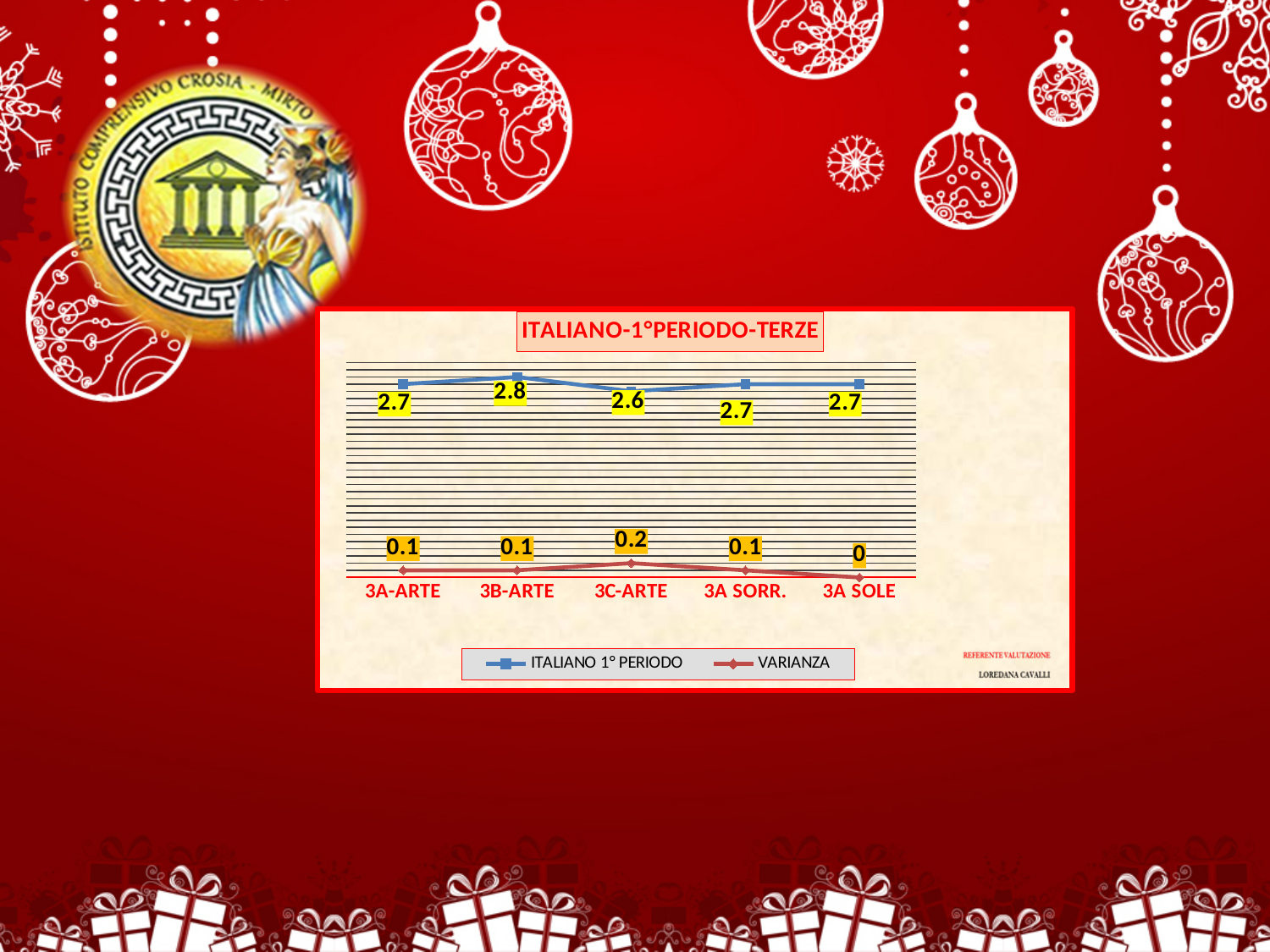
Which category has the highest ITALIANO 1° PERIODO value? 3B-ARTE What is the VARIANZA value for 3A SOLE? 0 Which category has the highest VARIANZA value? 3C-ARTE What is the ITALIANO 1° PERIODO value for 3B-ARTE? 2.8 What is the VARIANZA value for 3C-ARTE? 0.2 Which category has the lowest ITALIANO 1° PERIODO value? 3C-ARTE Which is larger, the ITALIANO 1° PERIODO value for 3B-ARTE or for 3A SORR.? 3B-ARTE How many categories are shown on the x axis? 5 What is the difference between the ITALIANO 1° PERIODO values for 3B-ARTE and 3C-ARTE? 0.2 How many series does the legend list? 2 What is the ITALIANO 1° PERIODO value for 3C-ARTE? 2.6 What type of chart is shown? Line chart